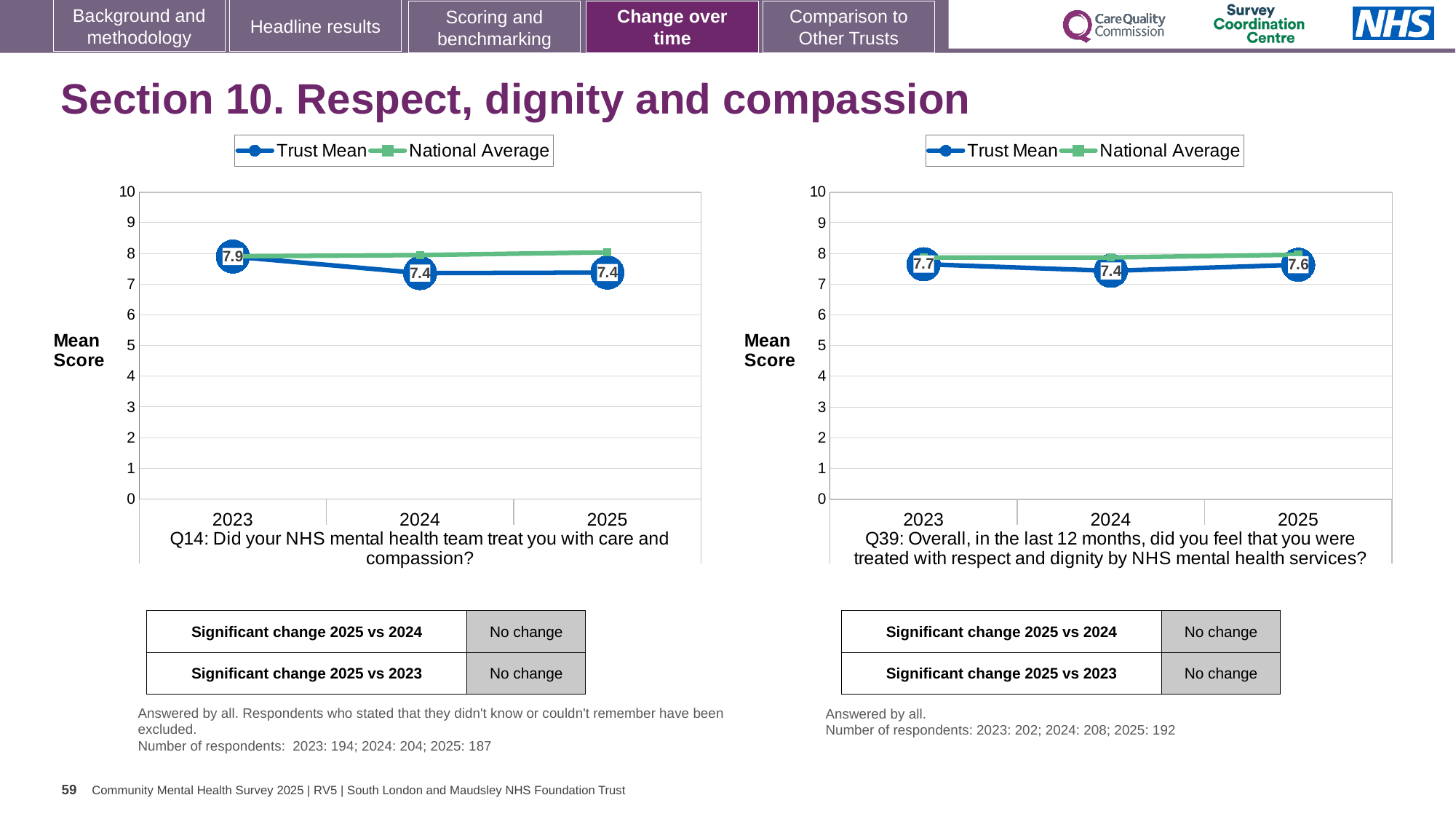
In the Q14 chart (left), which year has the highest Trust Mean score? 2023 How many years are plotted on the x axis of the Q39 chart (right)? 3 In the Q39 chart (right), which year has the lowest Trust Mean score? 2024 In the Q14 chart (left), what is the difference between the Trust Mean scores for 2023 and 2024? 0.5 In the Q39 chart (right), is the Trust Mean score for 2023 or 2025 higher? 2023 In the Q39 chart (right), what is the Trust Mean score for 2025? 7.6 In the Q14 chart (left), is the National Average for 2025 greater or less than 7? greater What type of chart is the Q39 chart (right)? Line chart In the Q14 chart (left), what is the Trust Mean score for 2023? 7.9 How many series does the legend of the Q14 chart (left) list? 2 In the Q39 chart (right), what is the Trust Mean score for 2024? 7.4 In the Q14 chart (left), what is the Trust Mean score for 2025? 7.4